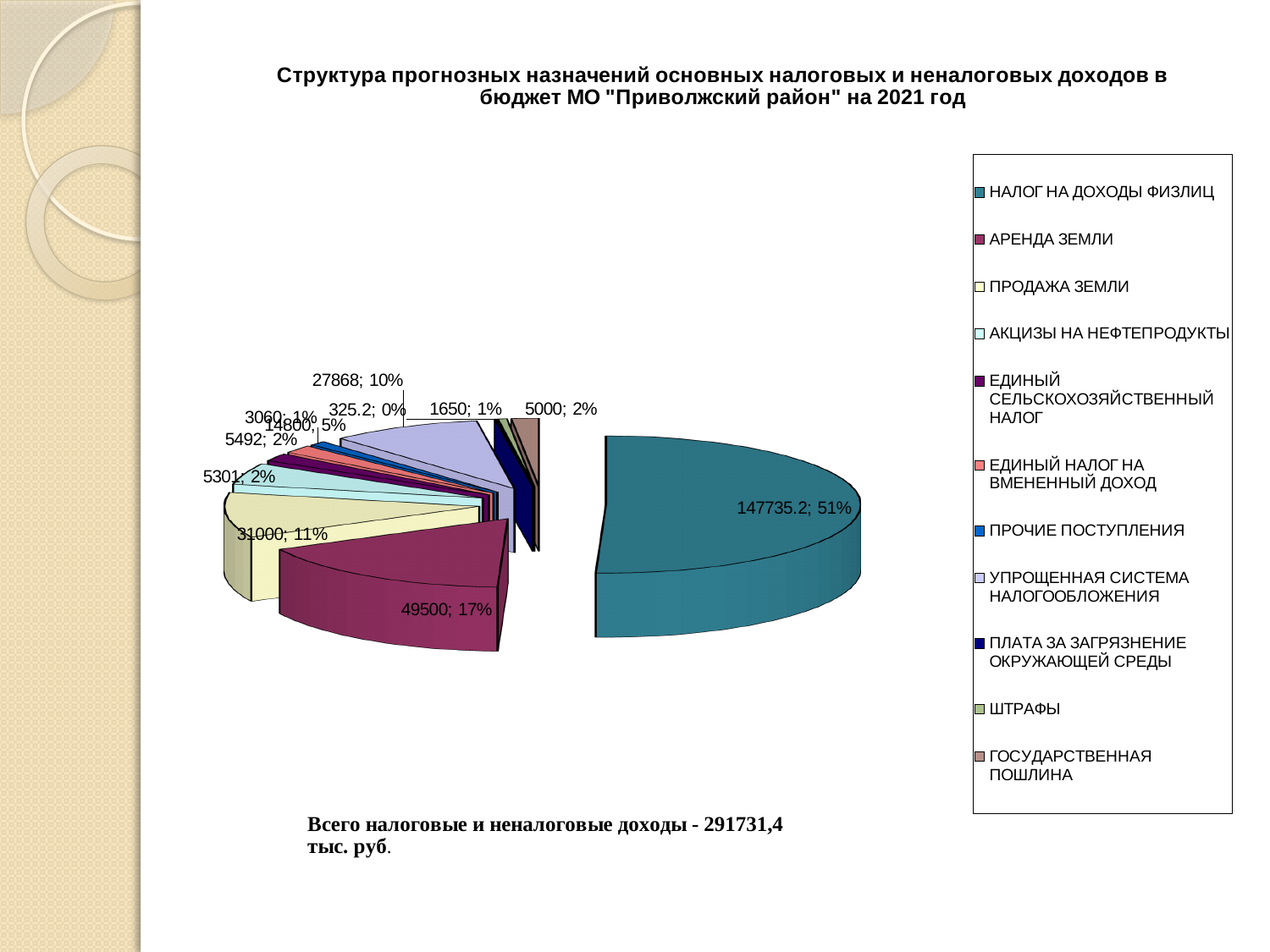
How many categories does the legend of the pie chart list? 11 What total of tax and non-tax revenues is stated below the chart? 291731,4 тыс. руб. What kind of chart is shown on the slide? Pie chart What share of the pie does АРЕНДА ЗЕМЛИ account for? 17% What is the difference between the values for АРЕНДА ЗЕМЛИ and ПРОДАЖА ЗЕМЛИ? 18500 Which category has the largest slice of the pie? НАЛОГ НА ДОХОДЫ ФИЗЛИЦ What share of the pie is shown for ШТРАФЫ? 1% What value is shown for УПРОЩЕННАЯ СИСТЕМА НАЛОГООБЛОЖЕНИЯ? 27868 Which is larger, the value for ЕДИНЫЙ НАЛОГ НА ВМЕНЕННЫЙ ДОХОД or the value for ГОСУДАРСТВЕННАЯ ПОШЛИНА? ЕДИНЫЙ НАЛОГ НА ВМЕНЕННЫЙ ДОХОД What value and share are shown for НАЛОГ НА ДОХОДЫ ФИЗЛИЦ? 147735.2; 51% Which category has the smallest slice of the pie? ПЛАТА ЗА ЗАГРЯЗНЕНИЕ ОКРУЖАЮЩЕЙ СРЕДЫ What value is shown for ПРОДАЖА ЗЕМЛИ? 31000